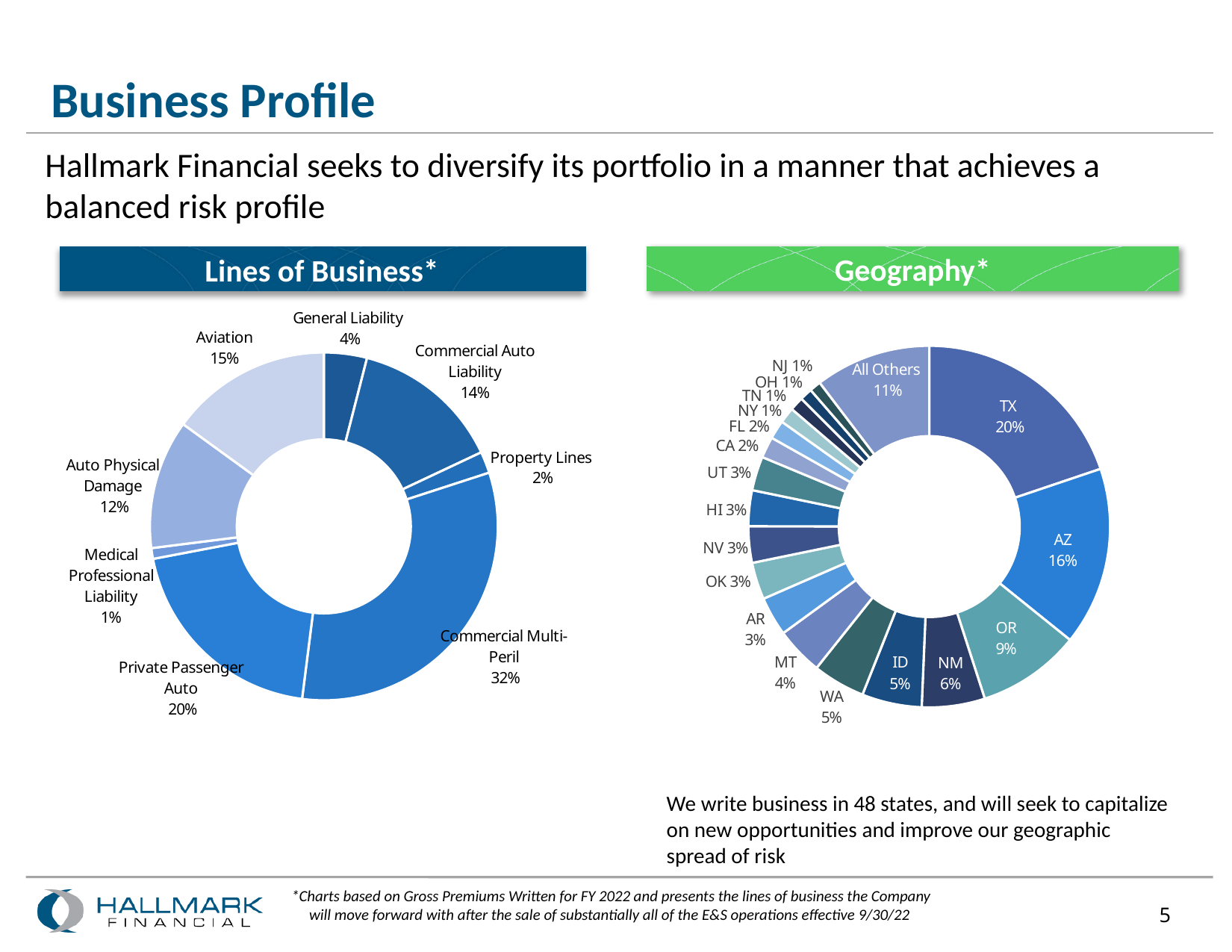
In the Lines of Business chart, what share does Commercial Multi-Peril represent? 32% In the Geography chart, what share does Texas (TX) represent? 20% In the Geography chart, what is the difference in percentage points between TX and AZ? 4 In the Geography chart, which individual state has the largest share? TX In the Lines of Business chart, which line of business has the smallest share? Medical Professional Liability In the Lines of Business chart, what share does Aviation represent? 15% In the Lines of Business chart, what is the difference in percentage points between Private Passenger Auto and Commercial Auto Liability? 6 In the Geography chart, which is larger, the share for AZ or the share for All Others? AZ What type of chart is used for the Geography breakdown? Donut (pie) chart In the Lines of Business chart, which line of business has the largest share? Commercial Multi-Peril In the Geography chart, what share does Oregon (OR) represent? 9% In the Lines of Business chart, how many lines of business are shown? 8